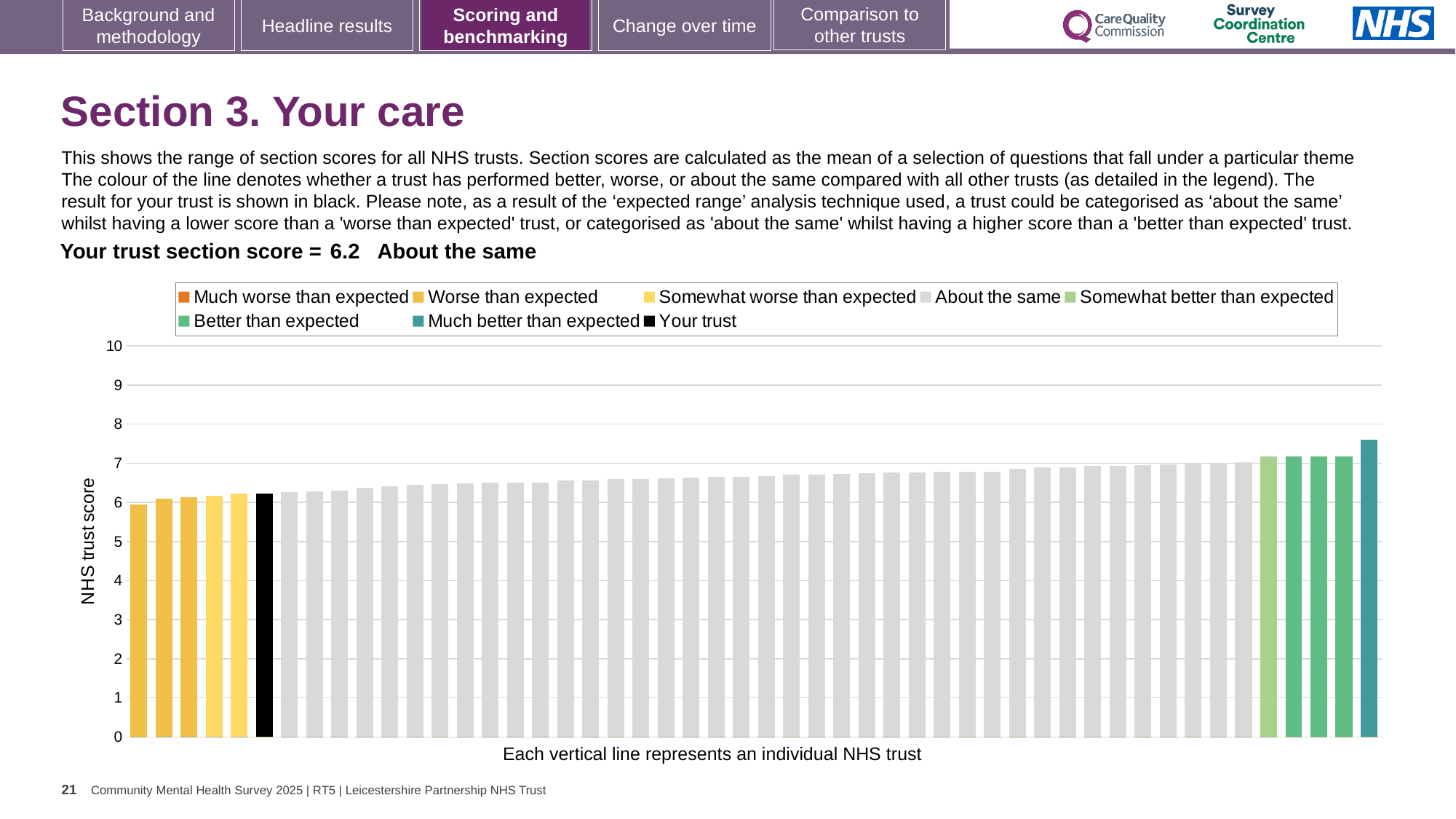
Do the bar values rise or fall from left to right along the x axis? rise Is the value for the tallest bar greater or less than 7? greater What kind of chart is shown on the slide? bar chart What is the section score for your trust shown on the slide? 6.2 Which legend category does the tallest bar belong to? Much better than expected How many entries does the chart legend list? 8 What colour is the bar representing your trust? black Which is larger, the rightmost bar or the leftmost bar? the rightmost bar What is the label on the y axis of the chart? NHS trust score Which category is your trust placed in for this section? About the same Is the value for your trust's bar greater or less than 7? less Is the value for the leftmost bar greater or less than 5? greater